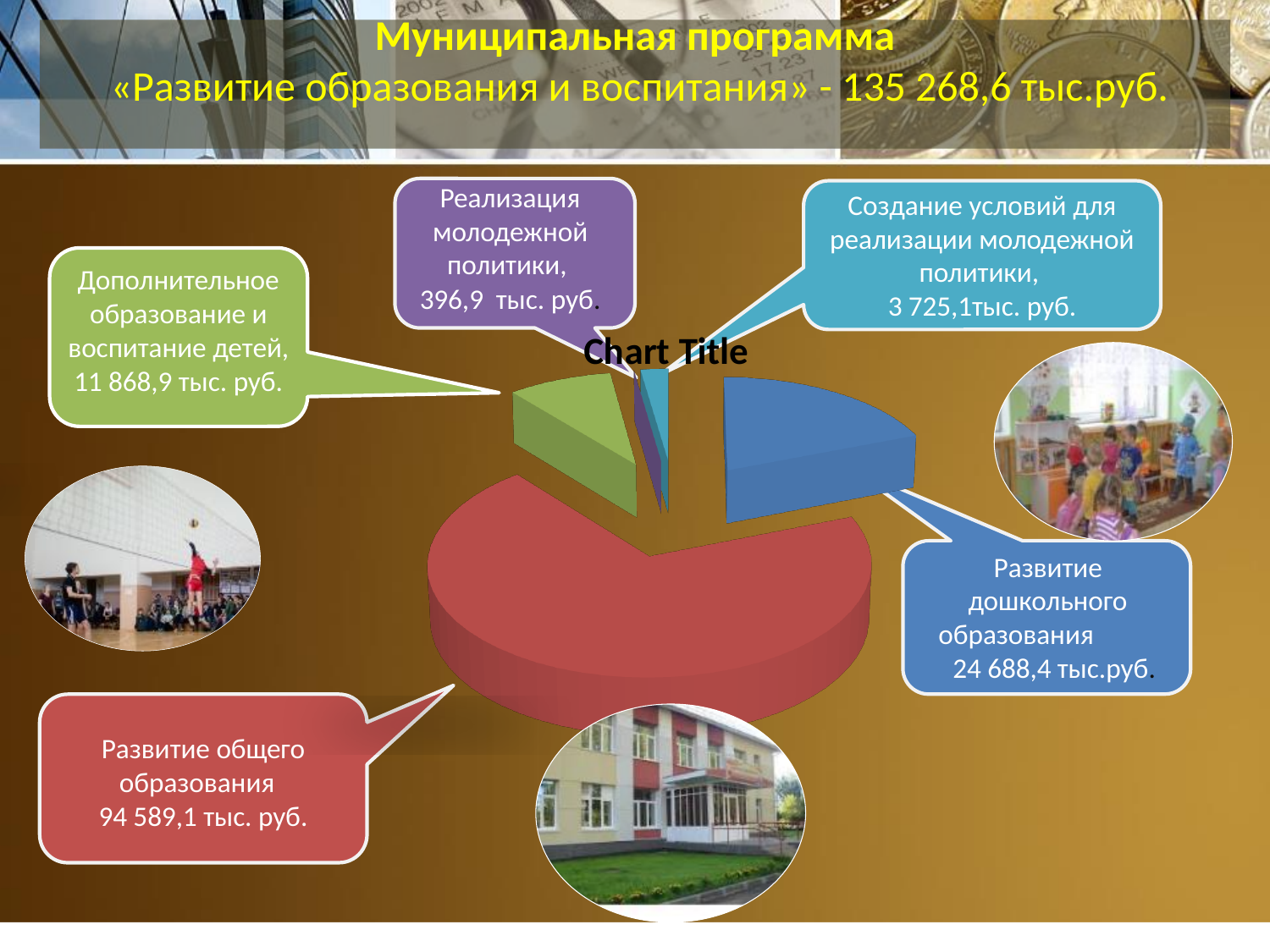
What kind of chart is shown on the slide? pie chart What is the difference between the values for Развитие общего образования and Развитие дошкольного образования? 69 900,7 тыс. руб. What is the value shown for Реализация молодежной политики? 396,9 тыс. руб. Which programme area has the smallest slice of the pie chart? Реализация молодежной политики What is the value shown for Развитие дошкольного образования? 24 688,4 тыс.руб. Which programme area has the largest slice of the pie chart? Развитие общего образования What colour is the slice for Развитие общего образования? red What is the value shown for Дополнительное образование и воспитание детей? 11 868,9 тыс. руб. Which is larger: the value for Дополнительное образование и воспитание детей or the value for Создание условий для реализации молодежной политики? Дополнительное образование и воспитание детей How many slices does the pie chart have? 5 What is the value shown for Создание условий для реализации молодежной политики? 3 725,1 тыс. руб. What is the title printed above the pie chart? Chart Title